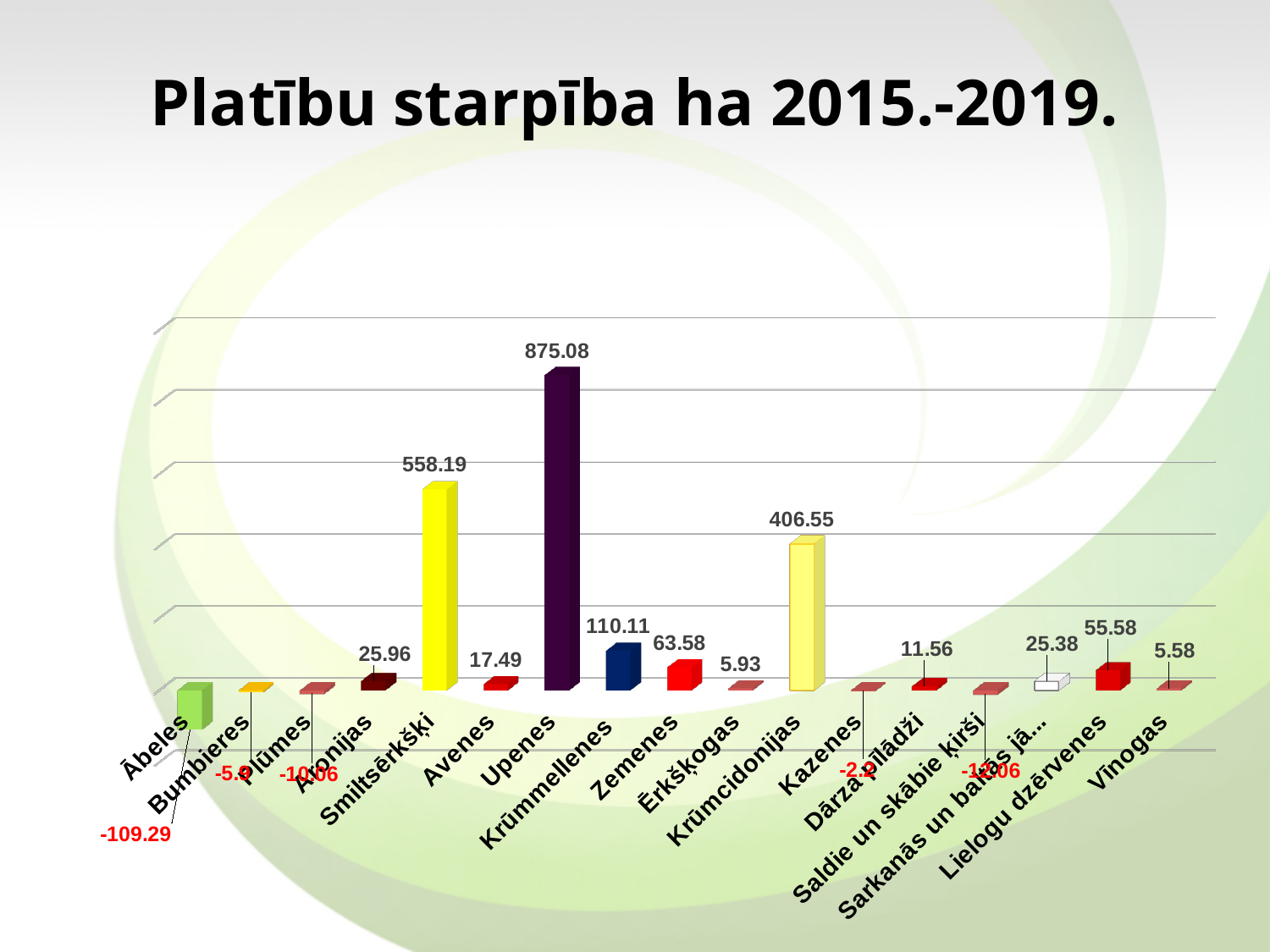
How many categories are shown on the x axis? 17 Which is larger, the value for Krūmmellenes or the value for Zemenes? Krūmmellenes What is the value for Krūmcidonijas? 406.55 What is the value for Ābeles? -109.29 What kind of chart is shown on the slide? Bar chart Which category has the highest value? Upenes What is the value for Lielogu dzērvenes? 55.58 What is the value for Smiltsērkšķi? 558.19 Which category has the lowest value? Ābeles What is the title of the chart? Platību starpība ha 2015.-2019. What is the difference between the values for Upenes and Smiltsērkšķi? 316.89 What is the value for Upenes? 875.08